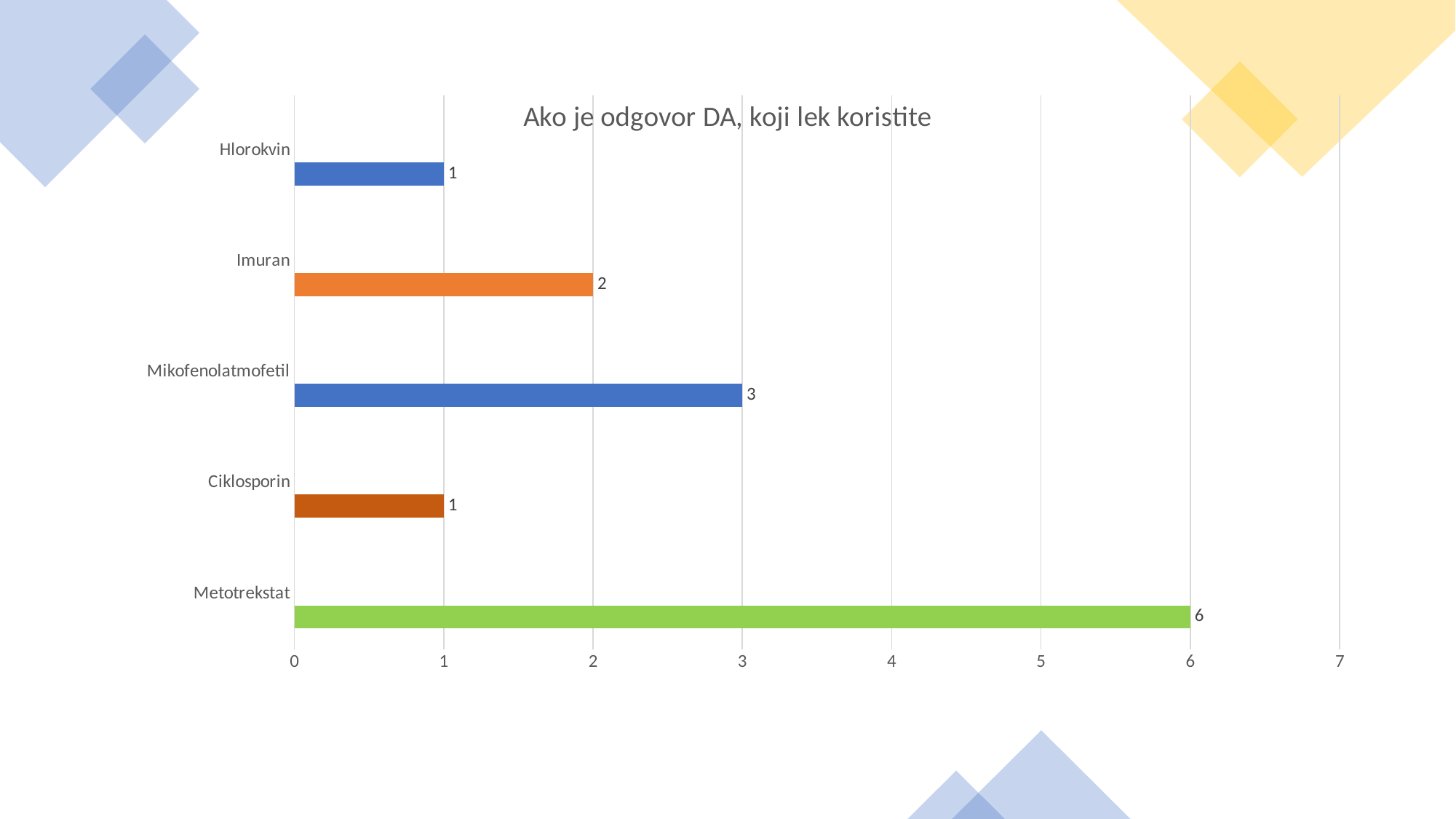
How many drugs are shown in the chart? 5 What is the title of the chart? Ako je odgovor DA, koji lek koristite What is the value for Imuran? 2 Which drug has the highest value? Metotrekstat Is the value for Metotrekstat greater or less than 5? greater What is the value for Metotrekstat? 6 What kind of chart is shown on the slide? bar chart What colour is the bar for Metotrekstat? green Which is larger, the value for Imuran or the value for Ciklosporin? Imuran What is the difference between the values for Mikofenolatmofetil and Hlorokvin? 2 What is the difference between the values for Metotrekstat and Mikofenolatmofetil? 3 What is the value for Mikofenolatmofetil? 3